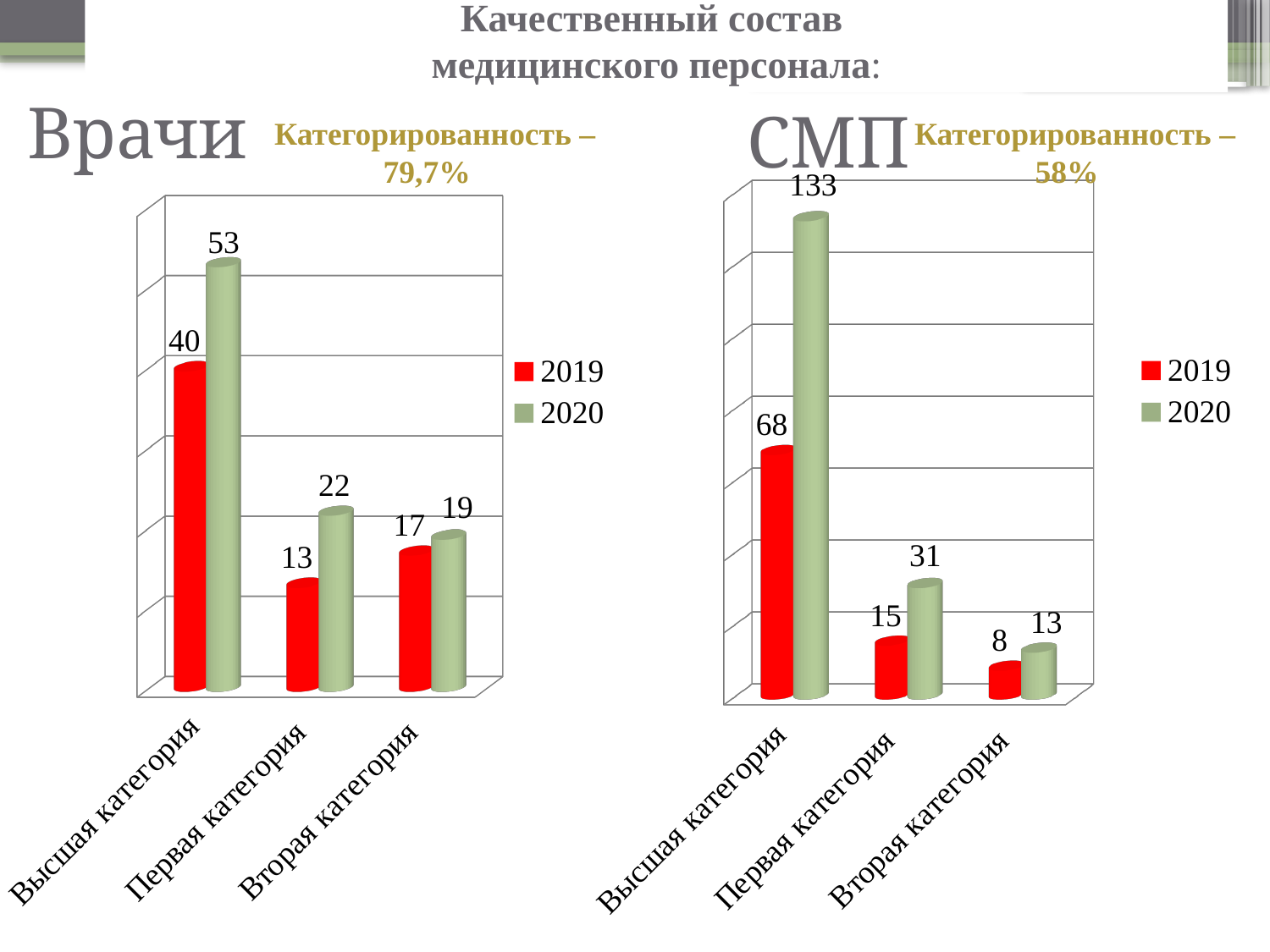
How many categories are shown on the x axis of the СМП chart? 3 In the Врачи chart, what is the 2020 value for Высшая категория? 53 In the СМП chart, what is the 2020 value for Высшая категория? 133 What type of chart is the СМП chart? Bar chart In the Врачи chart, which is larger for Вторая категория: the 2019 value or the 2020 value? 2020 How many series does the legend of the Врачи chart list? 2 In the Врачи chart, which category has the lowest 2019 value? Первая категория In the Врачи chart, what is the 2019 value for Первая категория? 13 In the СМП chart, which category has the highest 2020 value? Высшая категория In the СМП chart, what is the 2019 value for Вторая категория? 8 In the Врачи chart, what is the difference between the 2020 and 2019 values for Высшая категория? 13 In the СМП chart, what is the difference between the 2020 and 2019 values for Первая категория? 16